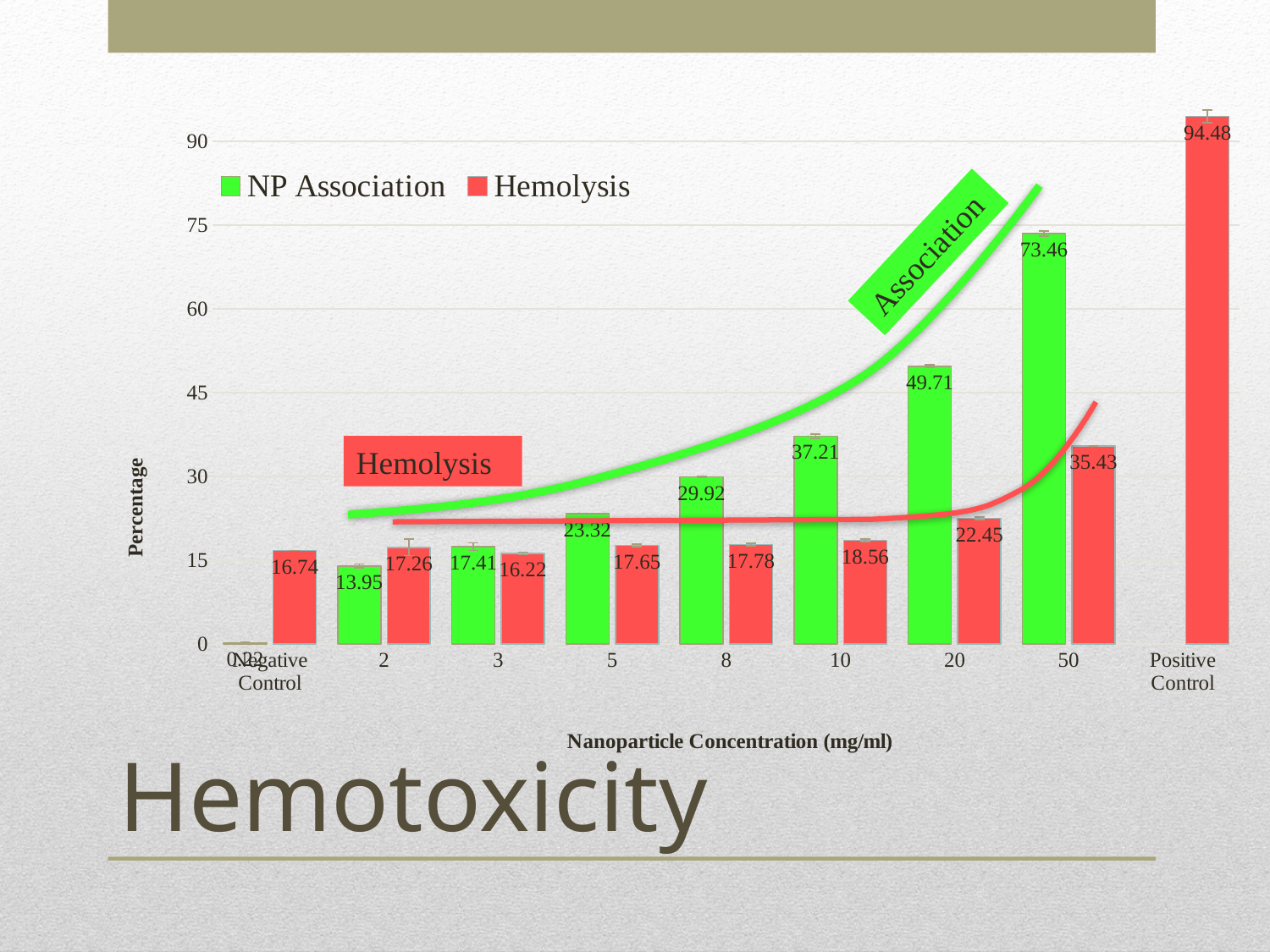
Is the NP Association value at 20 mg/ml greater or less than 45? greater At 3 mg/ml, which is larger: NP Association or Hemolysis? NP Association How many categories are shown on the x axis? 9 Among the numbered concentrations (2 to 50 mg/ml), which has the lowest NP Association value? 2 What is the Hemolysis value at a nanoparticle concentration of 20 mg/ml? 22.45 What is the NP Association value at a nanoparticle concentration of 50 mg/ml? 73.46 What is the difference between the NP Association and Hemolysis values at 50 mg/ml? 38.03 What kind of chart is shown on the slide? Bar chart Which category has the highest Hemolysis value? Positive Control What is the Hemolysis value for the Positive Control? 94.48 What is the NP Association value at a nanoparticle concentration of 8 mg/ml? 29.92 How many series does the legend list? 2